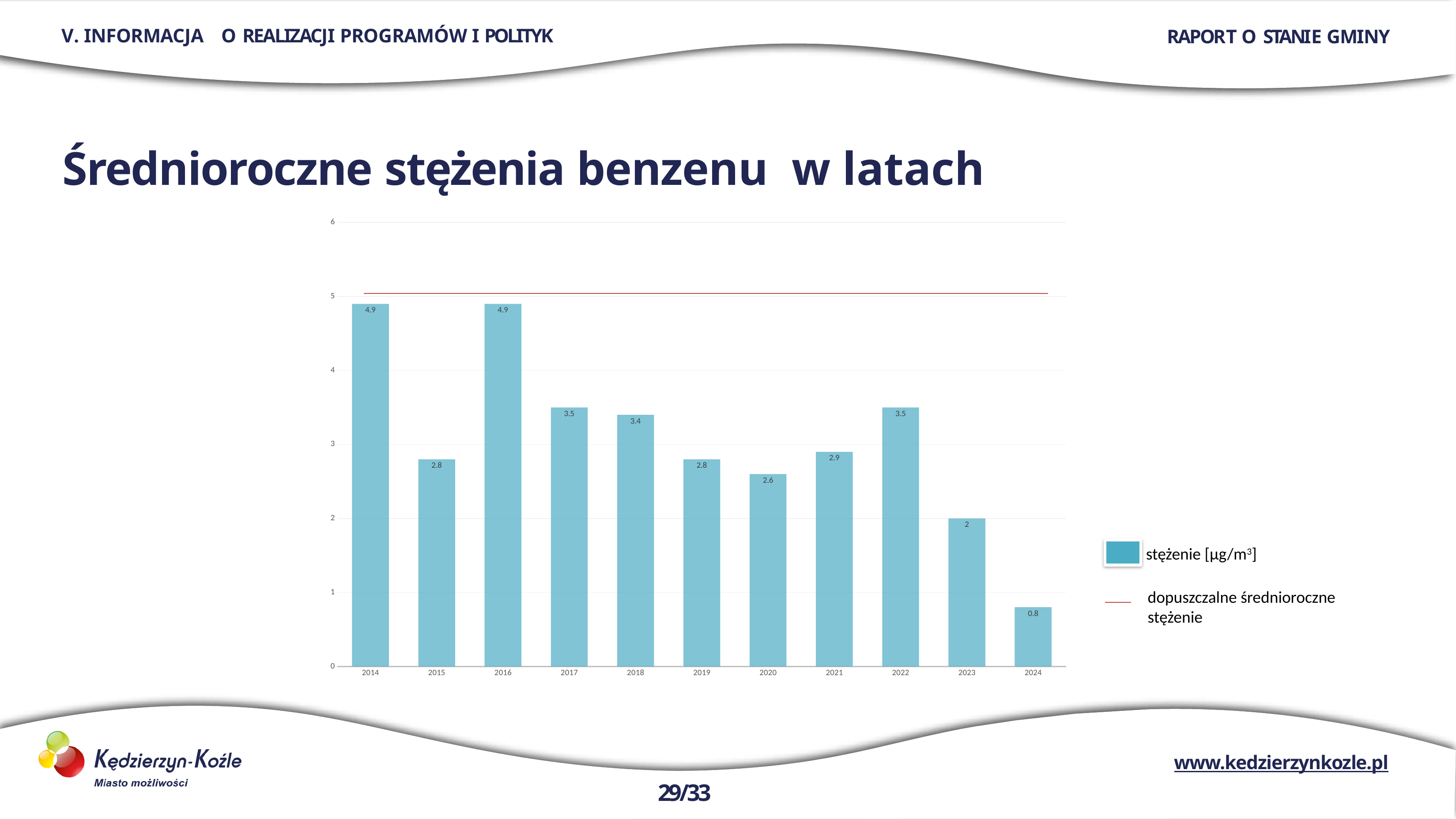
What is the difference between the values for 2014 and 2015? 2.1 How many years are shown on the x axis? 11 Which year has a larger value, 2017 or 2020? 2017 What kind of chart is shown on the slide? bar chart What is the value of the bar for 2024? 0.8 Which year has the lowest benzene concentration? 2024 How many entries does the legend list? 2 What is the value shown for 2021? 2.9 What is the benzene concentration value shown for 2018? 3.4 Is the value for 2016 greater or less than 4? greater What is the difference between the values for 2022 and 2023? 1.5 What is the highest concentration value shown on the chart? 4.9